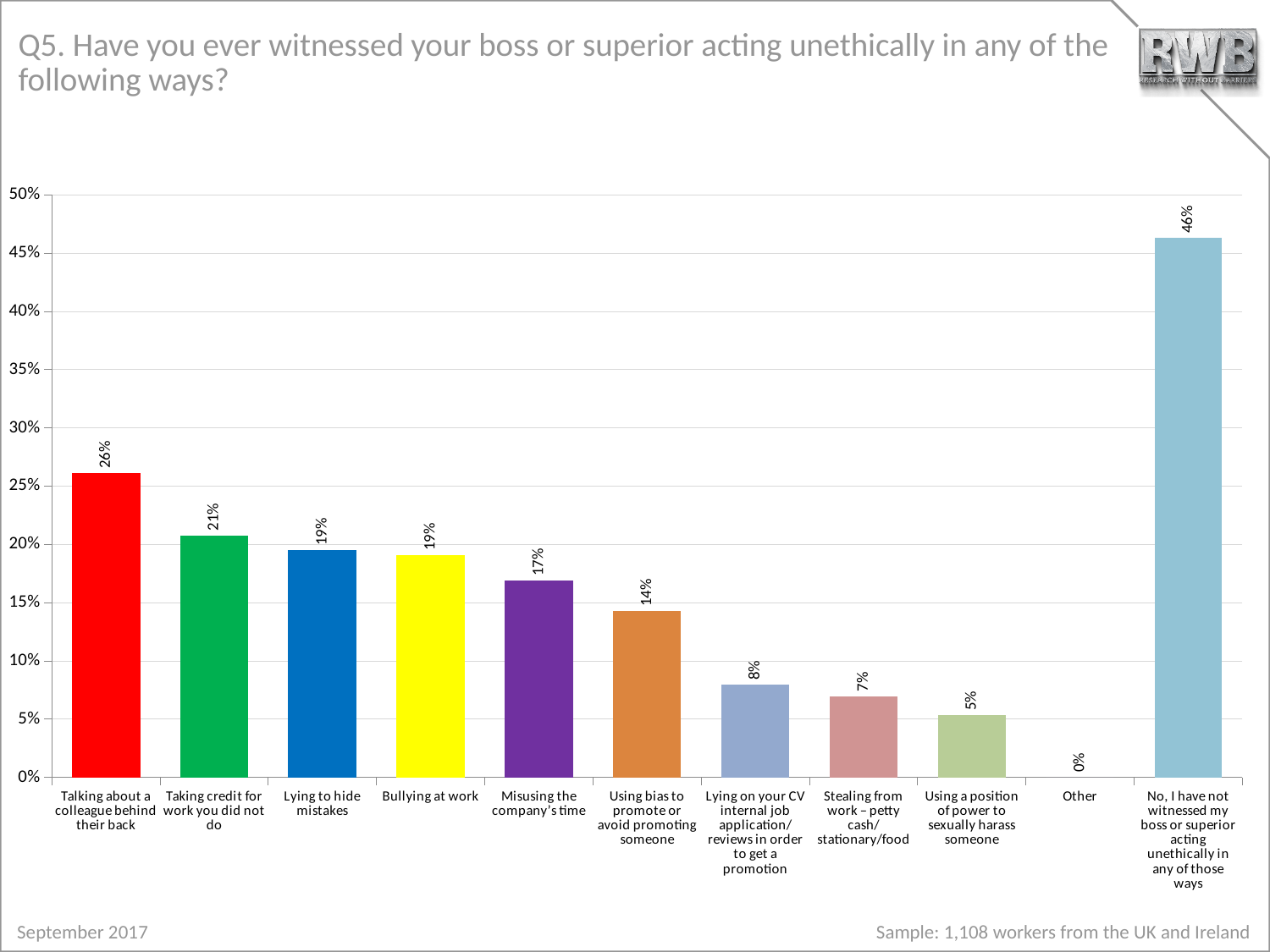
How many categories are shown on the x axis? 11 Is the value for 'Stealing from work – petty cash/stationary/food' greater or less than 10%? less What is the difference between 'Talking about a colleague behind their back' and 'Taking credit for work you did not do'? 5% What kind of chart is shown on the slide? bar chart Which category has the lowest value? Other What is the sample size stated at the bottom of the slide? 1,108 workers from the UK and Ireland What is the value for 'Using a position of power to sexually harass someone'? 5% Which category has the highest value? No, I have not witnessed my boss or superior acting unethically in any of those ways What is the value for 'Bullying at work'? 19% What percentage of respondents said they have not witnessed their boss or superior acting unethically in any of those ways? 46% Which is larger: 'Misusing the company's time' or 'Using bias to promote or avoid promoting someone'? Misusing the company's time What percentage of respondents witnessed their boss talking about a colleague behind their back? 26%